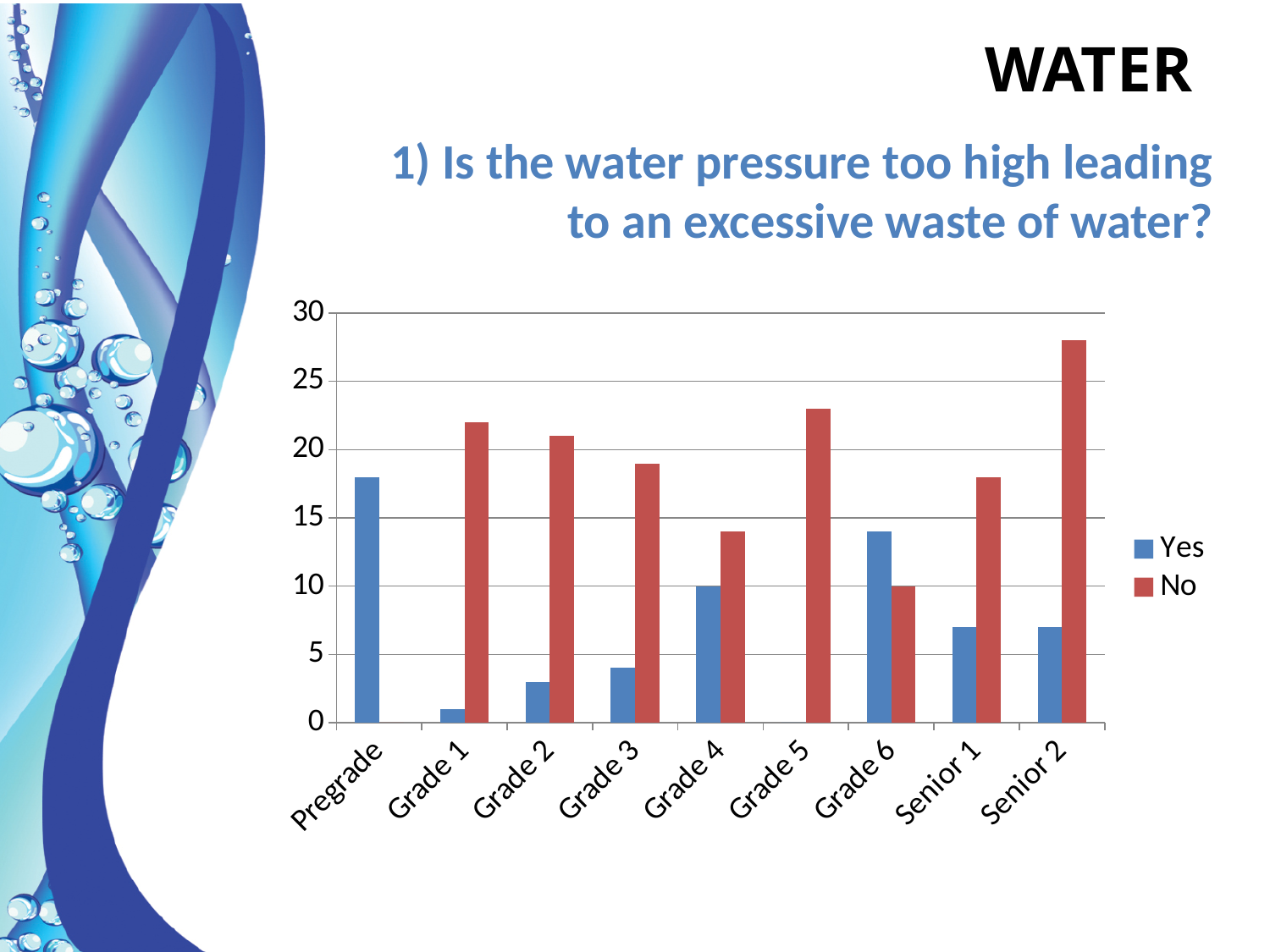
Do the 'Yes' values rise or fall from Grade 1 to Grade 4? rise For Grade 1, which is larger, the 'Yes' value or the 'No' value? No Which category has the highest 'Yes' value? Pregrade Is the 'Yes' value for Pregrade greater or less than 15? greater Is the 'No' value for Grade 5 greater or less than 20? greater Is the 'Yes' value for Grade 3 greater or less than 5? less Which category has the highest 'No' value? Senior 2 How many grade categories are shown on the x axis? 9 What kind of chart is shown on the slide? bar chart How many series does the legend list? 2 For Grade 6, which is larger, the 'Yes' value or the 'No' value? Yes